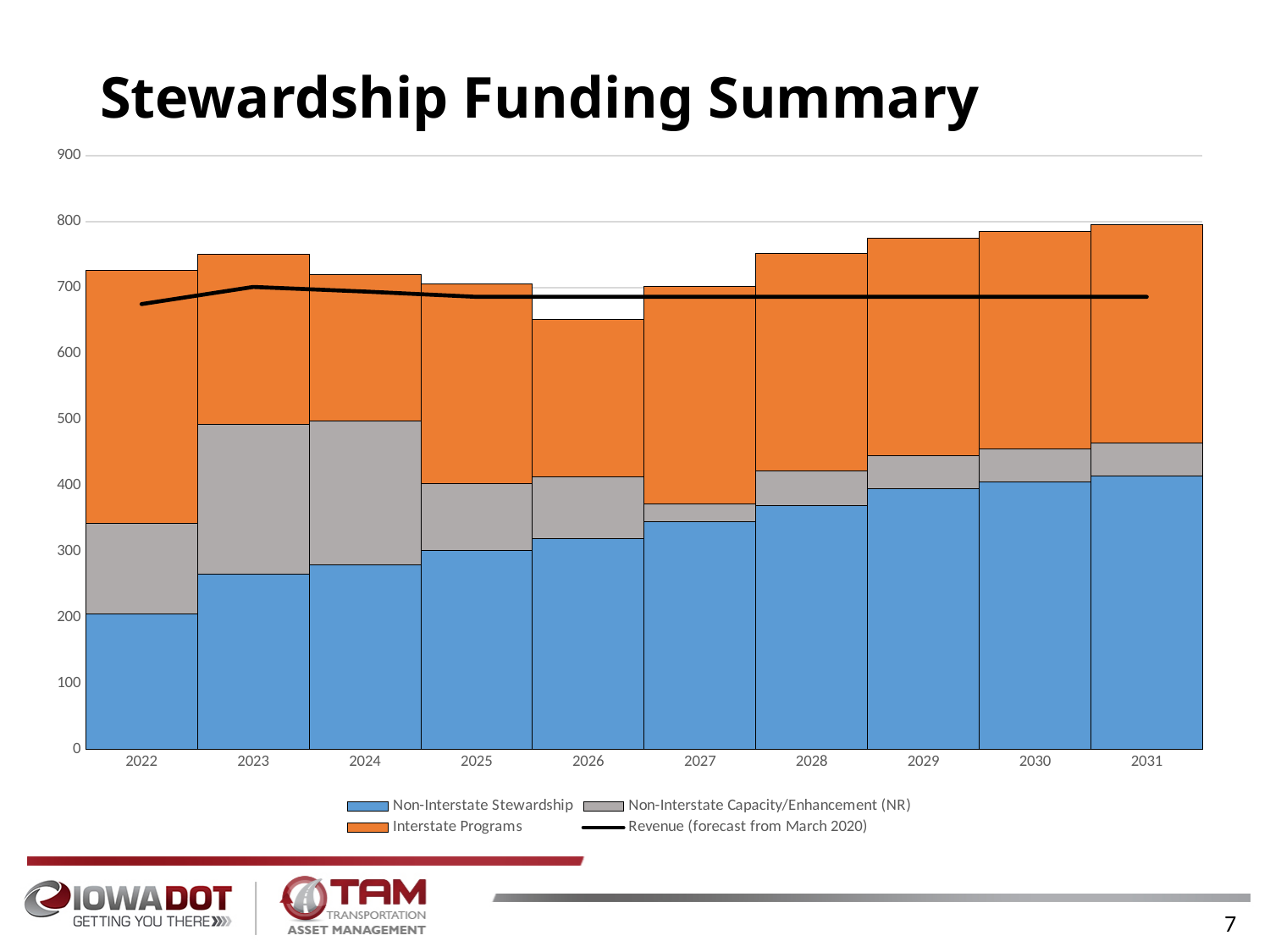
Which series is drawn as a black line in the chart? Revenue (forecast from March 2020) Is the Non-Interstate Stewardship value for 2022 greater or less than 300? less What is the title of the chart? Stewardship Funding Summary Does the Non-Interstate Stewardship series rise or fall from 2022 to 2031? rise Is the total stacked bar for 2031 greater or less than 700? greater Which year has the lowest Non-Interstate Stewardship value? 2022 What kind of chart is shown on the slide? combination stacked bar and line chart Which year has the lowest total stacked bar? 2026 Is the Revenue (forecast from March 2020) value for 2022 greater or less than 700? less How many series does the chart's legend list? 4 How many years are shown on the x axis of the chart? 10